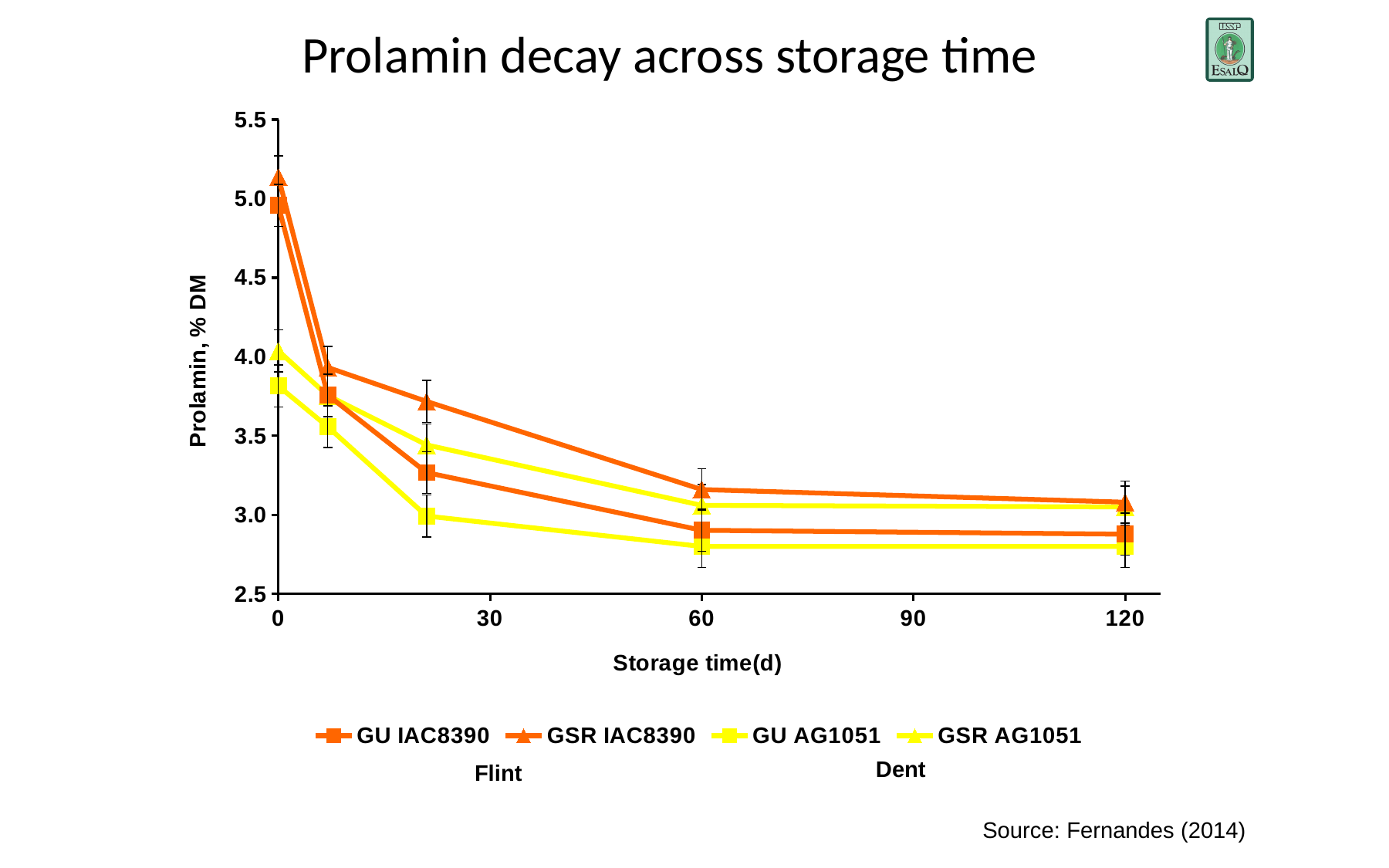
What kind of chart is shown on the slide? line chart Is the value for GU AG1051 at storage time 0 greater or less than 4.0? less Which series has the highest prolamin value at storage time 0? GSR IAC8390 What is the label of the y axis? Prolamin, % DM Is the value for GU AG1051 at storage time 60 greater or less than 3.0? less At storage time 0, which is larger: GSR IAC8390 or GU AG1051? GSR IAC8390 Which series has the lowest prolamin value at storage time 0? GU AG1051 Is the value for GSR IAC8390 at storage time 0 greater or less than 5.0? greater What is the title of the chart? Prolamin decay across storage time How many series does the legend list? 4 Do the prolamin values rise or fall as storage time increases? fall